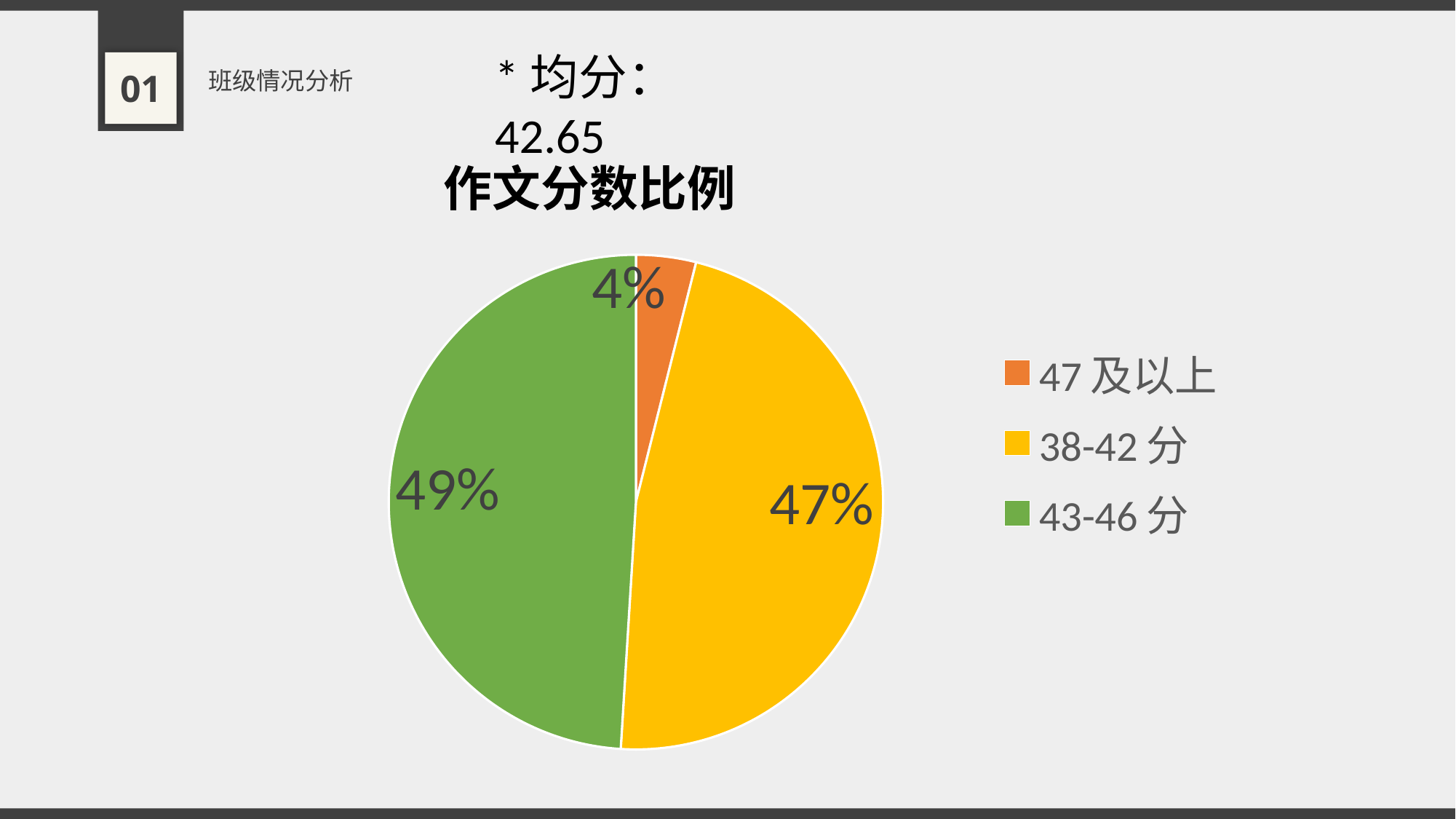
How many categories does the pie chart have? 3 What type of chart is shown on the slide? pie chart What share of the pie does the 43-46 分 slice represent? 49% What share of the pie does the 47 及以上 slice represent? 4% What is the title of the chart? 作文分数比例 What share of the pie does the 38-42 分 slice represent? 47% What colour is the slice for 47 及以上? orange Which category has the largest share of the pie? 43-46 分 What is the difference in percentage points between the 38-42 分 slice and the 47 及以上 slice? 43% What is the difference in percentage points between the 43-46 分 slice and the 38-42 分 slice? 2% Which category has the smallest share of the pie? 47 及以上 Which is larger, the share for 38-42 分 or the share for 47 及以上? 38-42 分